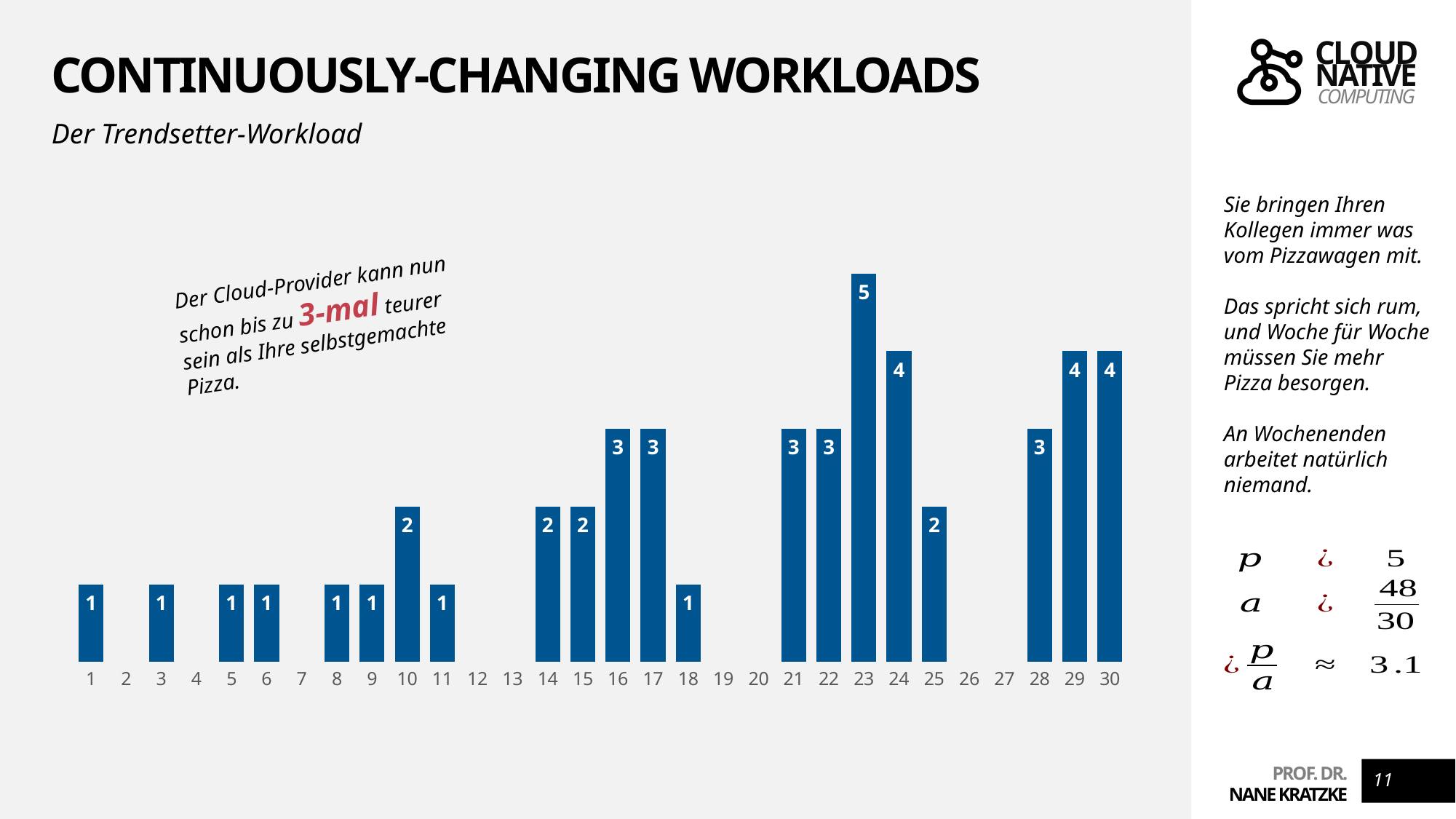
What is the difference between the values for day 29 and day 18? 3 What is the subtitle of the slide above the chart? Der Trendsetter-Workload What kind of chart is shown on the slide? bar chart How many days have a value of 4? 3 Which is larger, the value for day 16 or the value for day 25? day 16 What is the value for day 28? 3 What is the value for day 10? 2 Do the values generally rise or fall from day 1 to day 30? rise How many categories are shown on the x axis? 30 What is the difference between the values for day 23 and day 24? 1 What is the value for day 23? 5 Which day has the highest value? 23